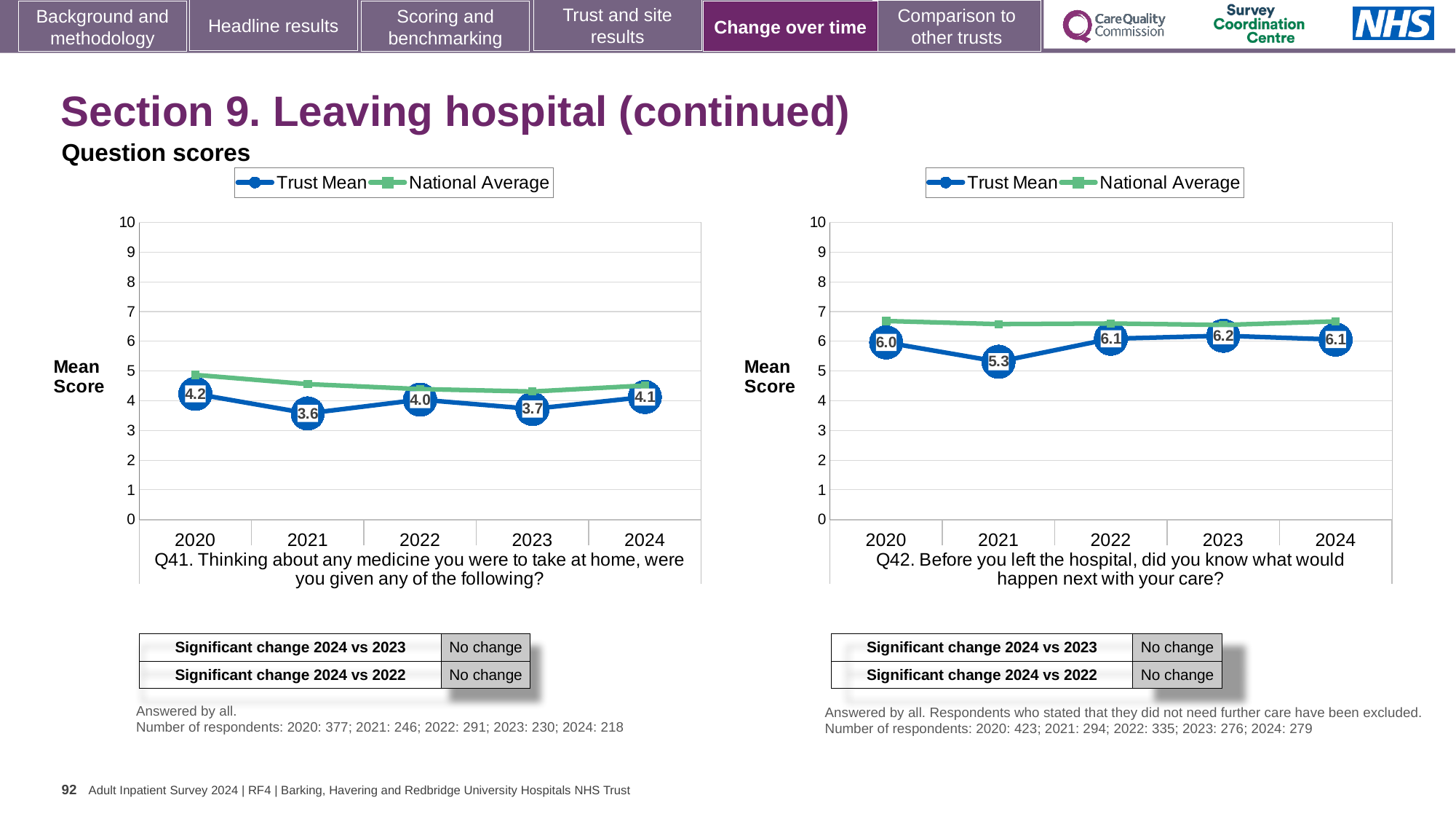
In the Q42 chart on the right, what is the Trust Mean score for 2023? 6.2 In the Q41 chart on the left, is the Trust Mean score for 2020 or 2023 larger? 2020 In the Q41 chart on the left, what is the Trust Mean score for 2024? 4.1 In the Q41 chart on the left, which year has the highest Trust Mean score? 2020 In the Q41 chart on the left, is the National Average for 2020 greater or less than 5? less How many years are plotted on the x axis of the Q42 chart on the right? 5 In the Q42 chart on the right, which year has the lowest Trust Mean score? 2021 How many series does the legend of the Q41 chart on the left list? 2 In the Q42 chart on the right, is the National Average for 2020 greater or less than 6? greater What type of chart is the Q42 chart on the right? Line chart In the Q42 chart on the right, what is the difference between the Trust Mean scores for 2023 and 2021? 0.9 In the Q41 chart on the left, what is the Trust Mean score for 2021? 3.6